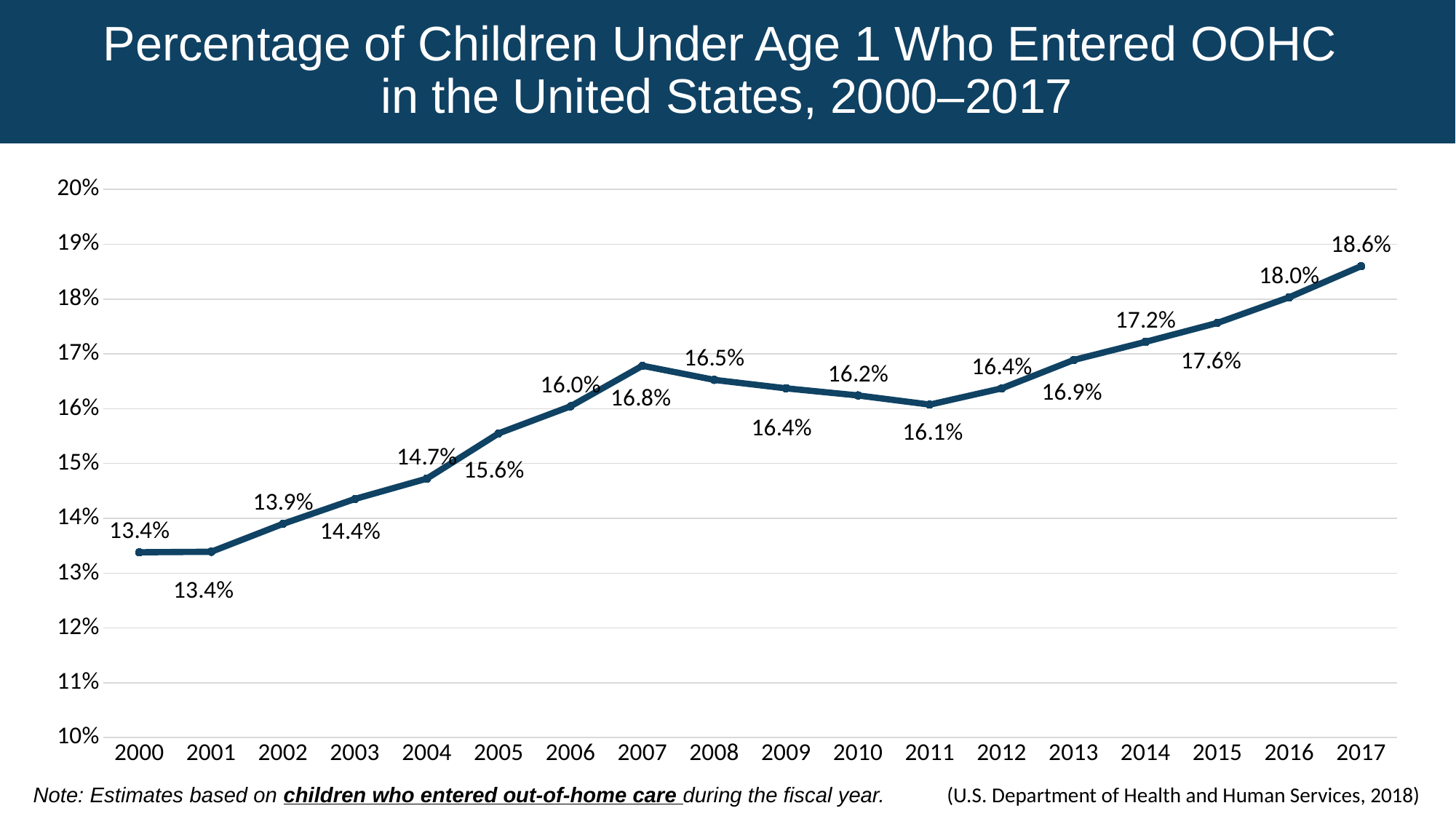
What was the percentage of children under age 1 who entered OOHC in 2007? 16.8% What was the percentage of children under age 1 who entered OOHC in 2000? 13.4% Is the value for 2016 greater or less than 17%? greater Which year has a higher percentage, 2005 or 2013? 2013 Which year has the highest percentage of children under age 1 who entered OOHC? 2017 What was the percentage of children under age 1 who entered OOHC in 2014? 17.2% How many years are plotted on the chart? 18 What was the percentage of children under age 1 who entered OOHC in 2011? 16.1% What type of chart is shown on the slide? Line chart Does the percentage rise or fall between 2011 and 2017? Rise What is the difference between the percentage in 2017 and the percentage in 2000? 5.2% What is the difference between the percentage in 2007 and the percentage in 2011? 0.7%